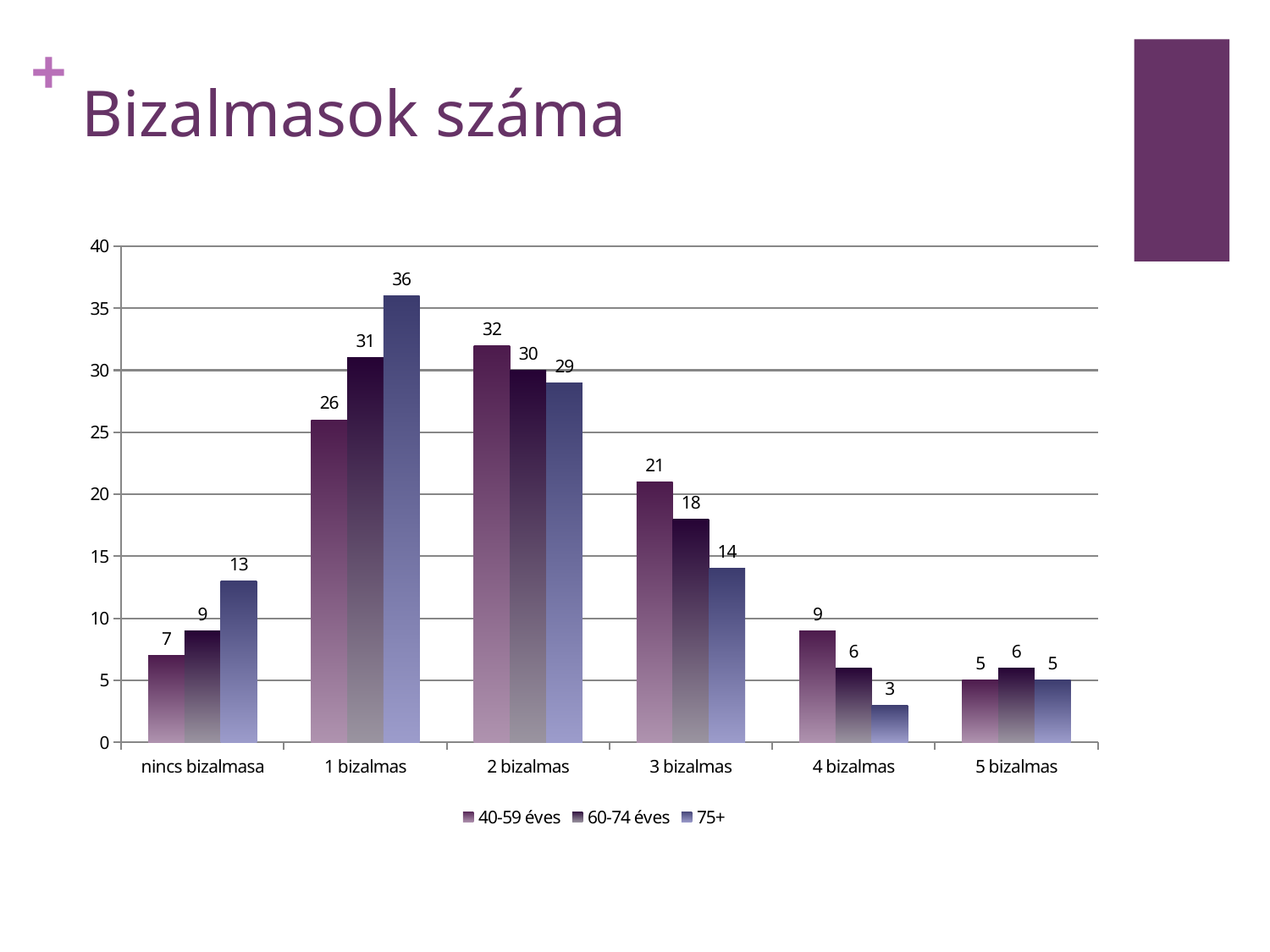
Do the values for the 75+ series rise or fall from '1 bizalmas' to '5 bizalmas'? fall (36, 29, 14, 3, then rise to 5) In the '3 bizalmas' category, which series has the larger value: 40-59 éves or 75+? 40-59 éves What is the value for the 75+ series in the '1 bizalmas' category? 36 Which category has the lowest value for the 75+ series? 4 bizalmas What is the difference between the 75+ and 40-59 éves values in the 'nincs bizalmasa' category? 6 Which category has the highest value for the 40-59 éves series? 2 bizalmas What kind of chart is shown on the slide? bar chart How many series does the legend list? 3 What is the title of the slide containing the chart? Bizalmasok száma How many categories are shown on the x axis? 6 What is the value for the 60-74 éves series in the '3 bizalmas' category? 18 What is the value for the 40-59 éves series in the '2 bizalmas' category? 32